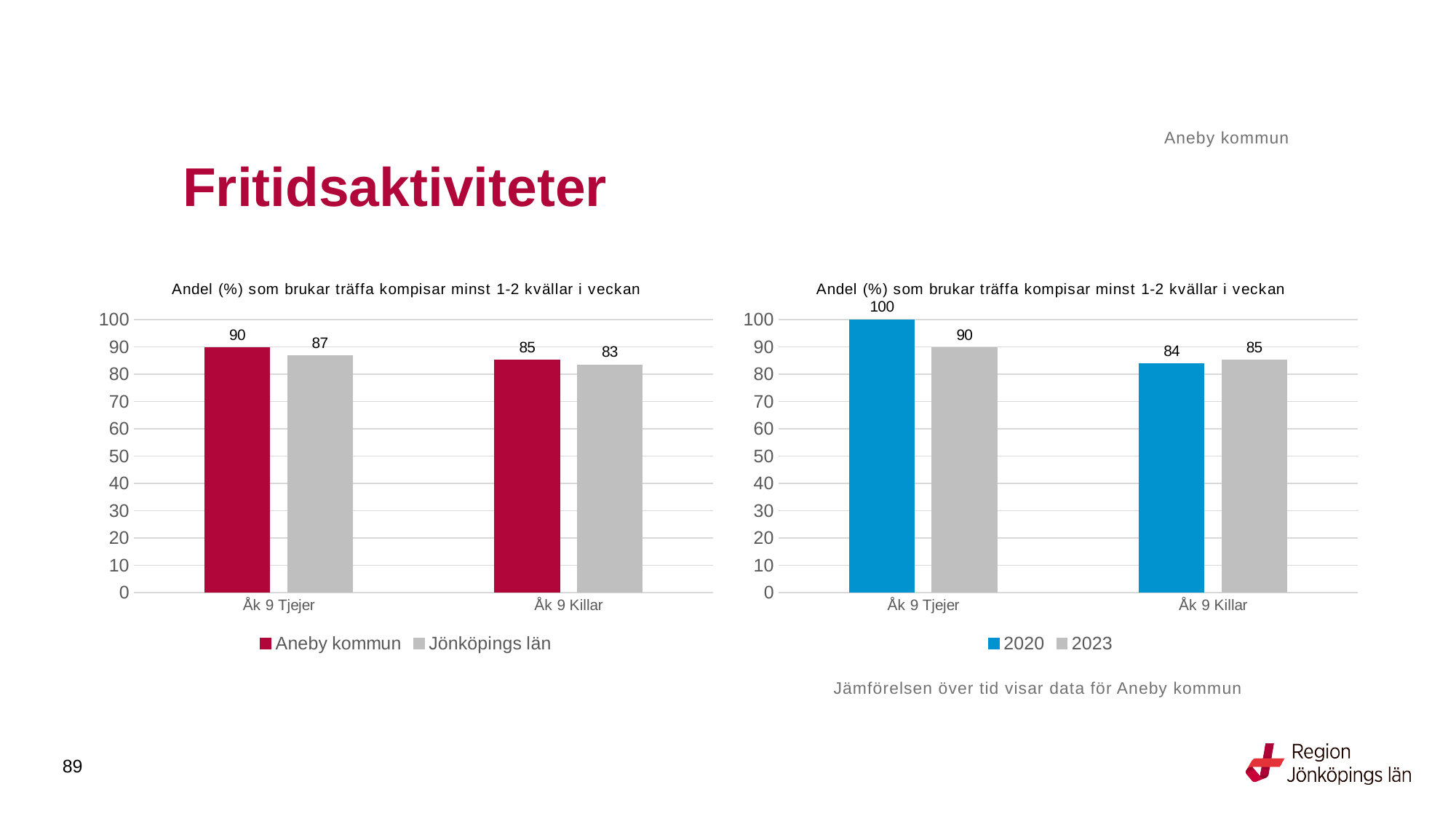
In the left chart, which series has the higher value for Åk 9 Tjejer, Aneby kommun or Jönköpings län? Aneby kommun How many categories are shown on the x axis of the left chart? 2 What kind of chart is the left chart? Bar chart In the right chart, what is the value for 2023 for Åk 9 Killar? 85 In the right chart, what is the value for 2020 for Åk 9 Tjejer? 100 In the left chart, what is the value for Jönköpings län for Åk 9 Killar? 83 In the right chart, which bar has the highest value? 2020, Åk 9 Tjejer In the left chart, what is the difference between Aneby kommun and Jönköpings län for Åk 9 Killar? 2 In the right chart, what is the difference between the 2020 and 2023 values for Åk 9 Tjejer? 10 In the right chart, which series has the higher value for Åk 9 Tjejer, 2020 or 2023? 2020 In the left chart, what is the value for Aneby kommun for Åk 9 Tjejer? 90 How many series does the legend of the right chart list? 2